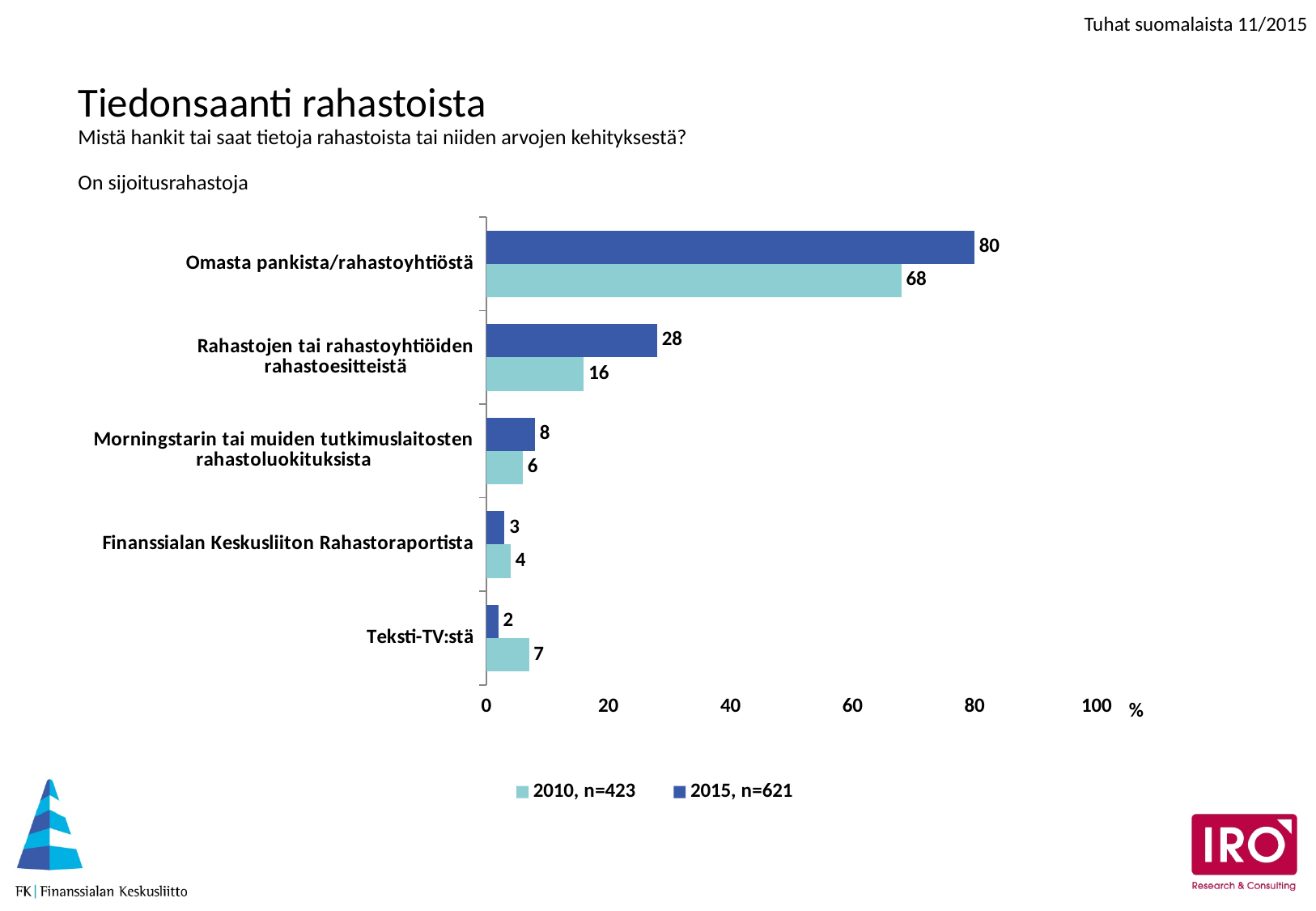
What is the 2010 value for Teksti-TV:stä? 7 Which category has the lowest 2015 value? Teksti-TV:stä What are the two legend entries on the chart? 2010, n=423 and 2015, n=621 What is the difference between the 2015 and 2010 values for Omasta pankista/rahastoyhtiöstä? 12 How many series does the legend list? 2 Which is larger for Finanssialan Keskusliiton Rahastoraportista, the 2010 value or the 2015 value? 2010 What is the 2010 value for Rahastojen tai rahastoyhtiöiden rahastoesitteistä? 16 What kind of chart is shown on the slide? Bar chart What is the 2015 value for Omasta pankista/rahastoyhtiöstä? 80 Which category has the highest 2015 value? Omasta pankista/rahastoyhtiöstä What is the 2015 value for Morningstarin tai muiden tutkimuslaitosten rahastoluokituksista? 8 How many categories are shown on the chart? 5